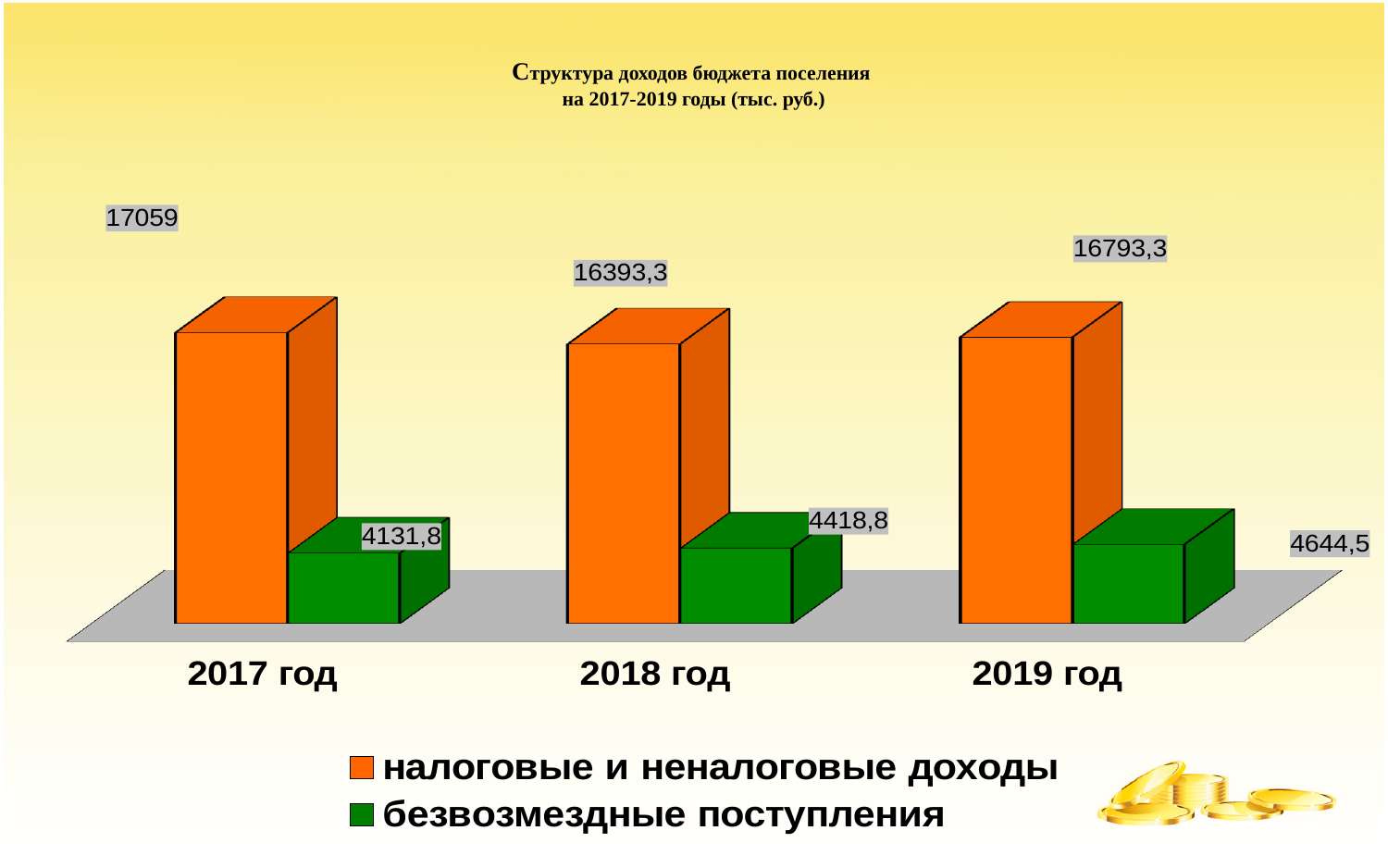
What is the value of безвозмездные поступления for 2018 год? 4418,8 Do the values of безвозмездные поступления rise or fall from 2017 год to 2019 год? rise Which colour represents безвозмездные поступления in the legend? green What kind of chart is shown on the slide? bar chart What is the difference between налоговые и неналоговые доходы in 2017 год and in 2018 год? 665,7 Which is larger: безвозмездные поступления in 2019 год or in 2017 год? 2019 год How many series does the legend list? 2 In which year is the value of безвозмездные поступления the lowest? 2017 год In which year is the value of налоговые и неналоговые доходы the highest? 2017 год What is the value of налоговые и неналоговые доходы for 2017 год? 17059 How many years are shown on the x axis? 3 What is the value of налоговые и неналоговые доходы for 2019 год? 16793,3